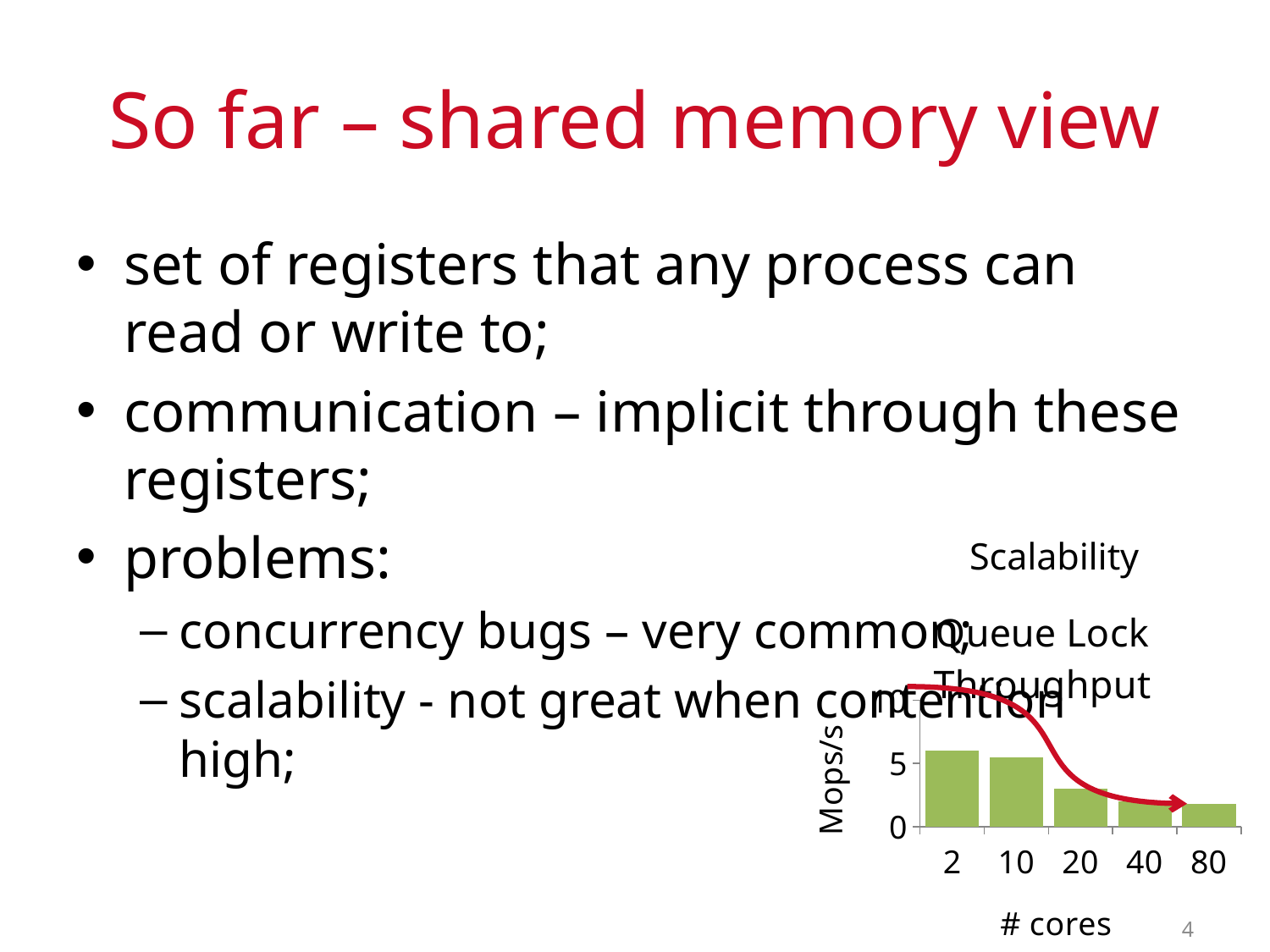
Which has the higher throughput, 10 cores or 40 cores? 10 cores Does the throughput rise or fall as the number of cores increases along the x axis? fall How many core counts (categories) are plotted on the x axis? 5 Is the throughput for 80 cores greater or less than 5 Mops/s? less What is the title of the chart? Queue Lock Throughput Is the throughput for 20 cores greater or less than 5 Mops/s? less Is the throughput for 2 cores greater or less than 5 Mops/s? greater What kind of chart is shown on the slide? bar chart Which has the higher throughput, 2 cores or 20 cores? 2 cores What is the label of the x axis of the chart? # cores Which core count has the highest throughput? 2